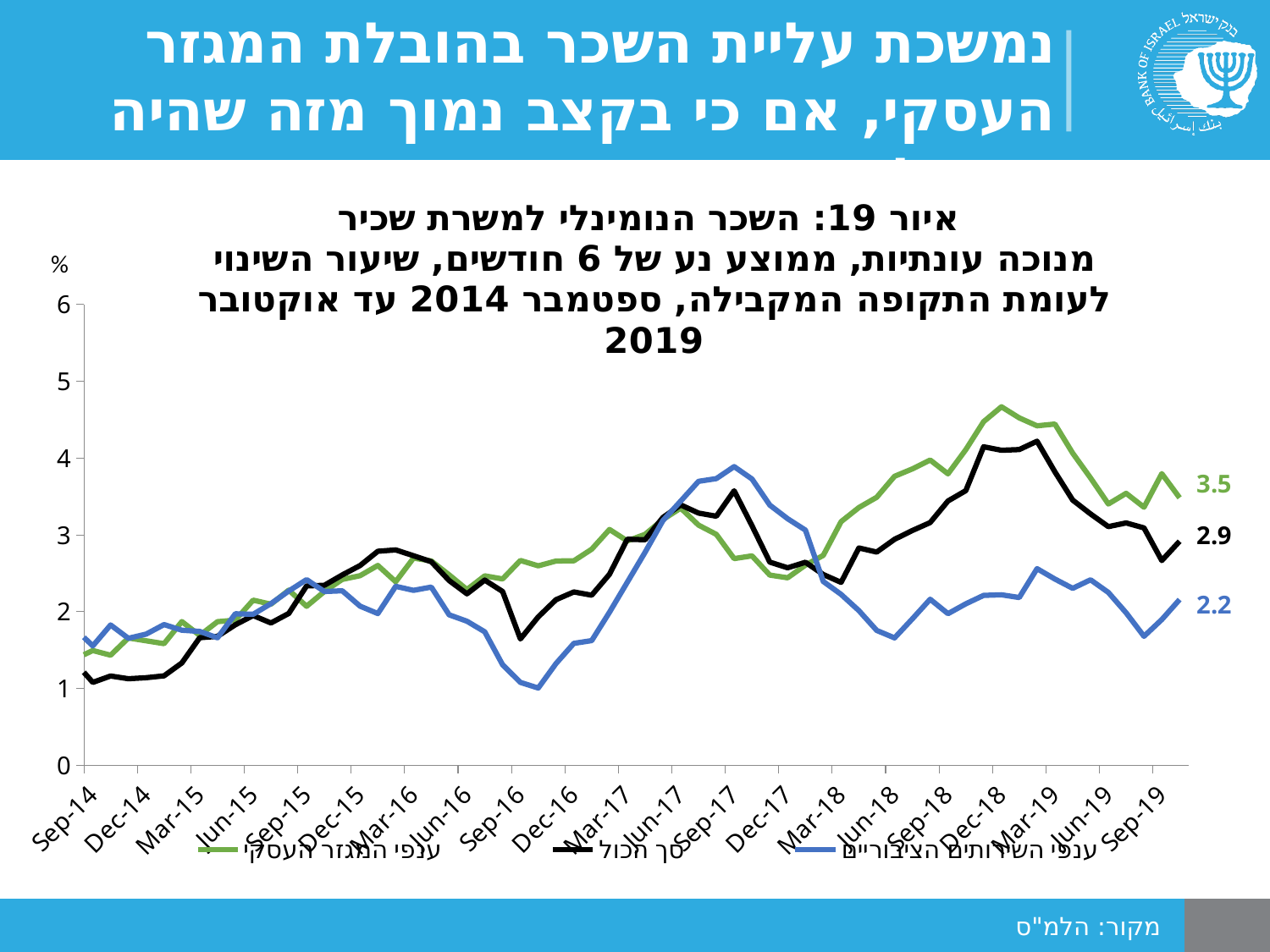
What is the difference between the final values of the business sector series and the public services series? 1.3 Does the public services series rise or fall overall from Sep-17 to Sep-19? fall Is the value of the business sector series at Dec-18 greater or less than 4? greater Which series has the lowest value at the end of the period (Sep-19)? ענפי השירותים הציבוריים What is the final labelled value for the business sector series (ענפי המגזר העסקי)? 3.5 What is the final labelled value for the total series (סך הכול)? 2.9 What kind of chart is shown on the slide? line chart At the end of the period, which is larger: the total series or the public services series? סך הכול Which series has the highest value at the end of the period (Sep-19)? ענפי המגזר העסקי How many series does the legend list? 3 What is the final labelled value for the public services series (ענפי השירותים הציבוריים)? 2.2 What unit is shown on the y axis? %